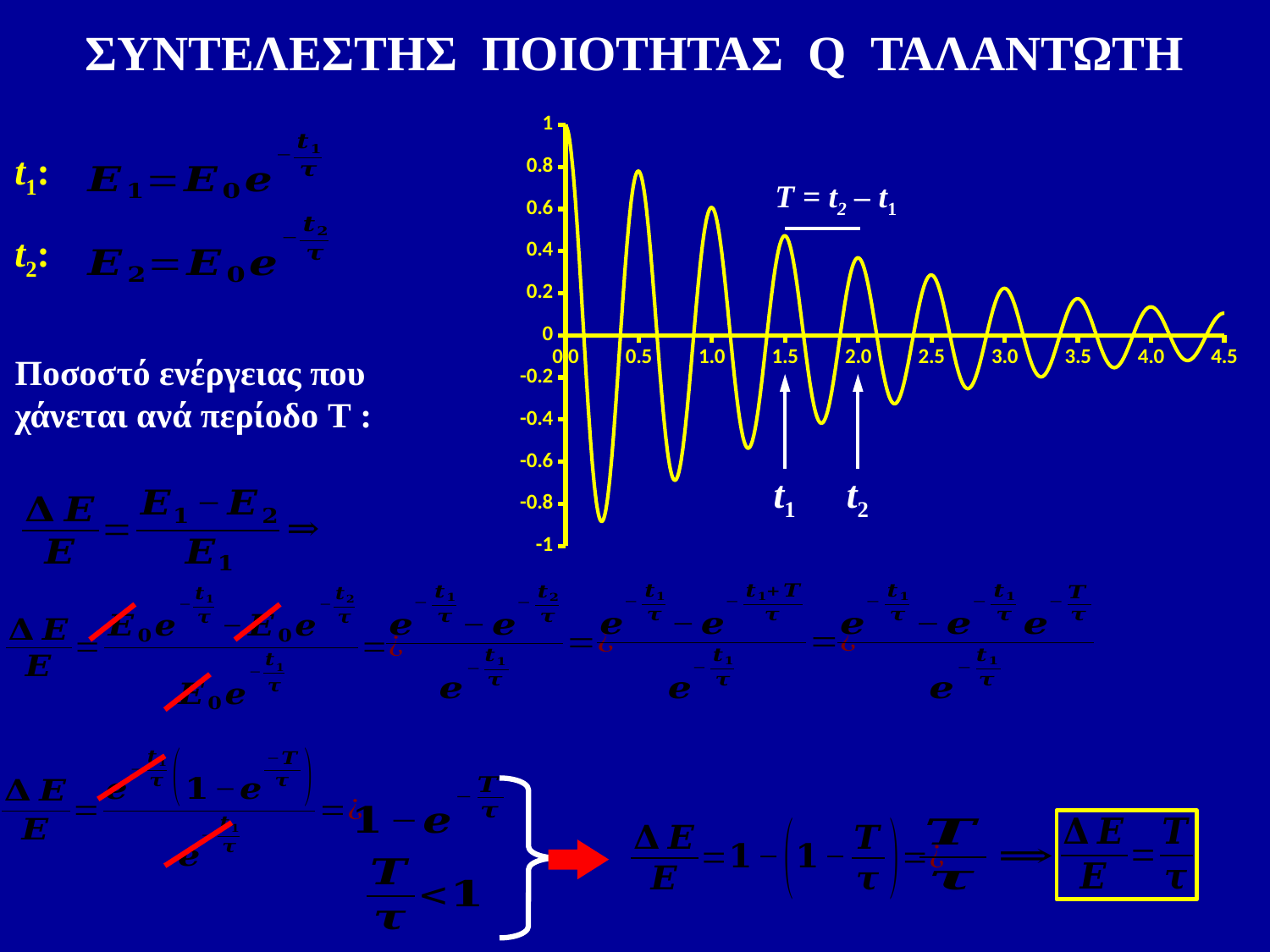
What kind of chart is shown on the slide? line chart Is the peak of the curve near x = 1.5 greater or less than 0.6? less Does the amplitude of the oscillation increase or decrease as the x axis value increases? decrease Is the peak of the curve near x = 0.5 greater or less than 0.6? greater Is the peak of the curve near x = 3.0 greater or less than 0.4? less What is the lowest value shown on the vertical axis of the chart? -1 What is the largest tick value shown on the horizontal axis of the chart? 4.5 What is the highest value shown on the vertical axis of the chart? 1 Which peak is higher: the one near x = 1.0 or the one near x = 2.0? the one near x = 1.0 Which two time points are marked with arrows below the curve on the chart? t1 and t2 How many labelled tick marks are there on the horizontal axis of the chart? 10